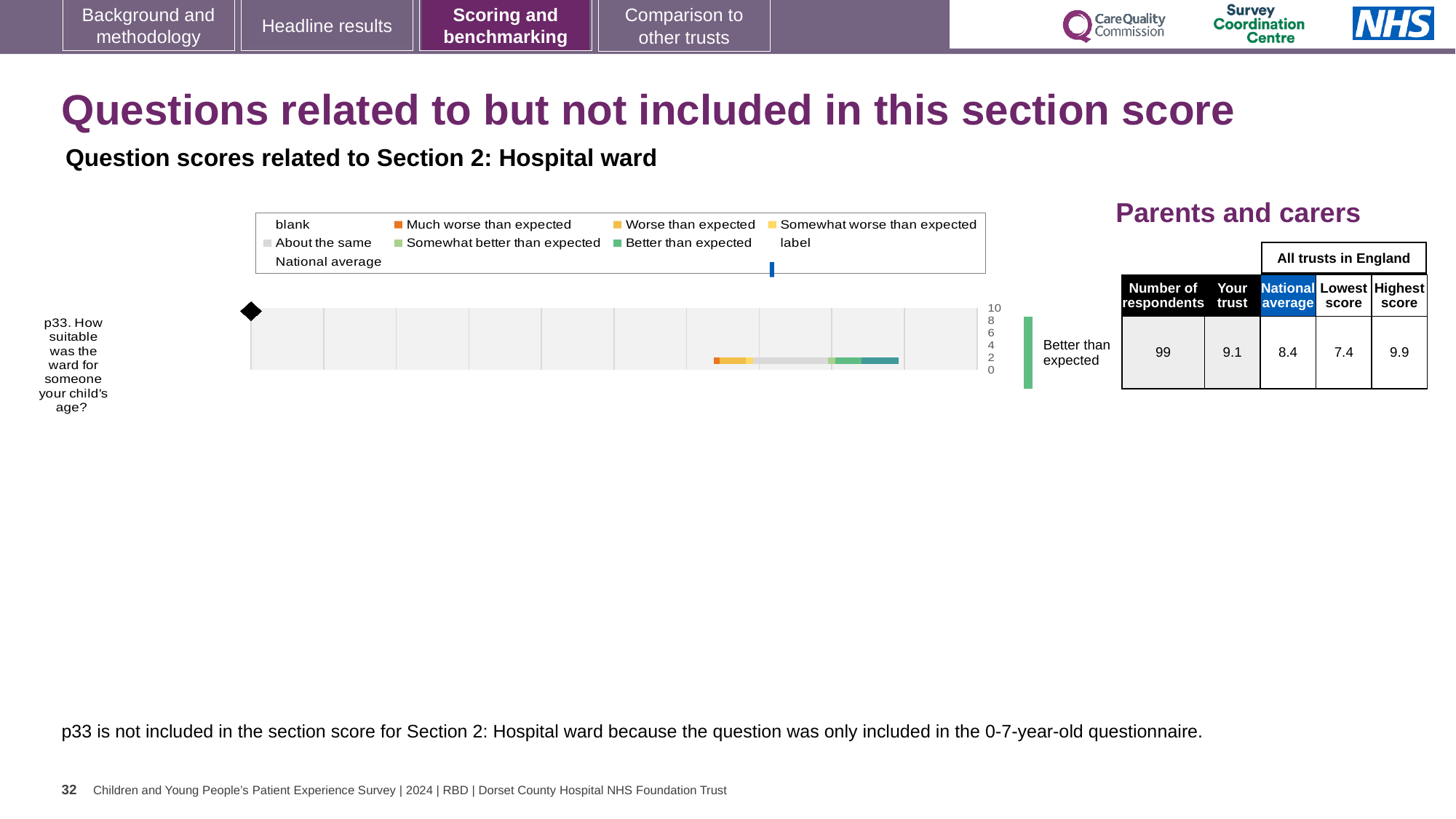
What rating label is shown to the right of the p33 bar? Better than expected What kind of chart is used to show the p33 question score? bar chart What is the highest score across all trusts in England for p33? 9.9 How many questions are plotted in the chart? 1 For p33, which is larger: the 'Your trust' score or the national average? Your trust What is the national average score for p33 in the Parents and carers table? 8.4 What is the lowest score across all trusts in England for p33? 7.4 Which question is plotted in the chart? p33. How suitable was the ward for someone your child's age? What is the 'Your trust' score for p33 in the Parents and carers table? 9.1 By how much does the 'Your trust' score for p33 exceed the national average? 0.7 How many respondents answered p33 according to the table? 99 What is the difference between the highest score and the lowest score for p33? 2.5